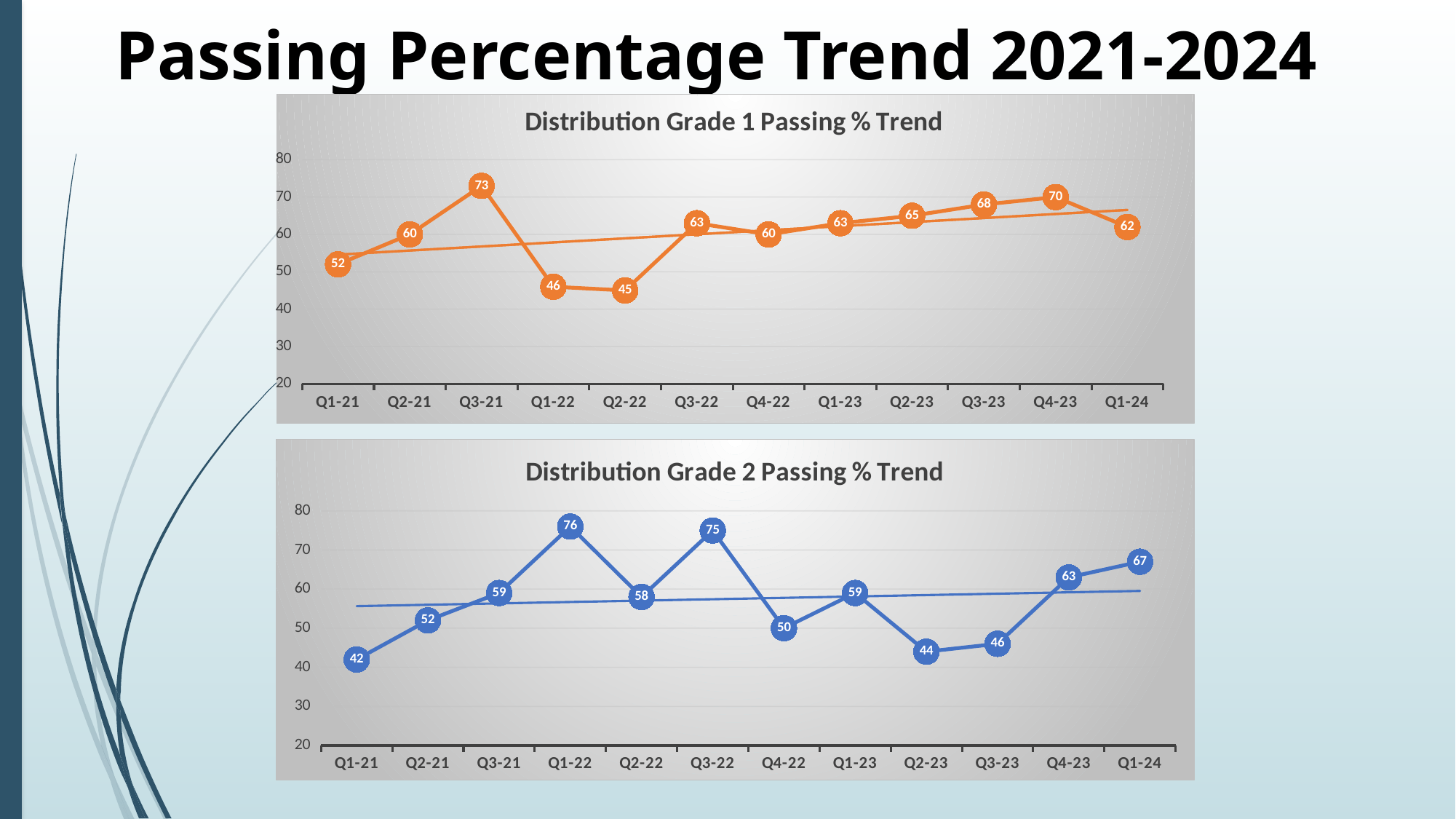
In the 'Distribution Grade 2 Passing % Trend' chart, which quarter has the lowest value? Q1-21 In the 'Distribution Grade 2 Passing % Trend' chart, what is the difference between the Q1-24 value and the Q1-21 value? 25 In the 'Distribution Grade 2 Passing % Trend' chart, which quarter has the highest value? Q1-22 In the 'Distribution Grade 1 Passing % Trend' chart, what is the difference between the Q4-23 value and the Q1-24 value? 8 In the 'Distribution Grade 2 Passing % Trend' chart, what is the value for Q1-22? 76 In the 'Distribution Grade 1 Passing % Trend' chart, which quarter has the lowest value? Q2-22 In the 'Distribution Grade 2 Passing % Trend' chart, is the value for Q2-23 greater or less than 50? less In the 'Distribution Grade 1 Passing % Trend' chart, do the values rise or fall from Q2-22 to Q4-23? rise In the 'Distribution Grade 1 Passing % Trend' chart, which is larger, the value for Q1-22 or the value for Q3-22? Q3-22 In the 'Distribution Grade 1 Passing % Trend' chart, what is the value for Q3-21? 73 How many quarters are plotted on the x axis of the 'Distribution Grade 1 Passing % Trend' chart? 12 What kind of chart is the 'Distribution Grade 2 Passing % Trend' chart? line chart